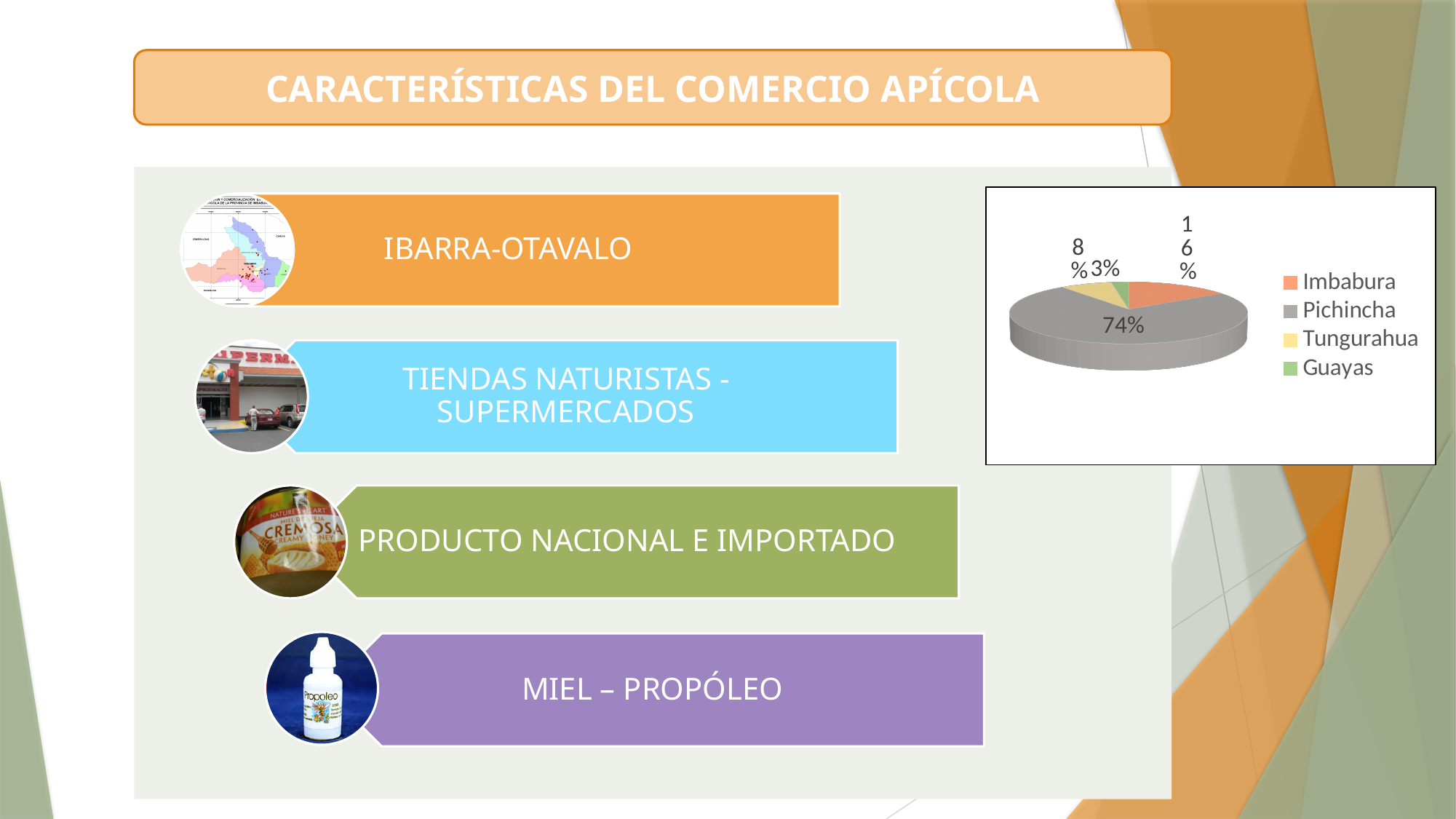
Which province has the smallest slice of the pie chart? Guayas Which province has the largest slice of the pie chart? Pichincha What colour represents Pichincha in the pie chart? gray What is the difference in percentage points between Pichincha and Imbabura in the pie chart? 58 What is the difference in percentage points between Tungurahua and Guayas in the pie chart? 5 How many categories does the pie chart's legend list? 4 What percentage does the pie chart show for Imbabura? 16% Which is larger in the pie chart, Imbabura or Tungurahua? Imbabura What percentage does the pie chart show for Guayas? 3% What percentage does the pie chart show for Pichincha? 74% What percentage does the pie chart show for Tungurahua? 8% What kind of chart is shown on the slide? pie chart